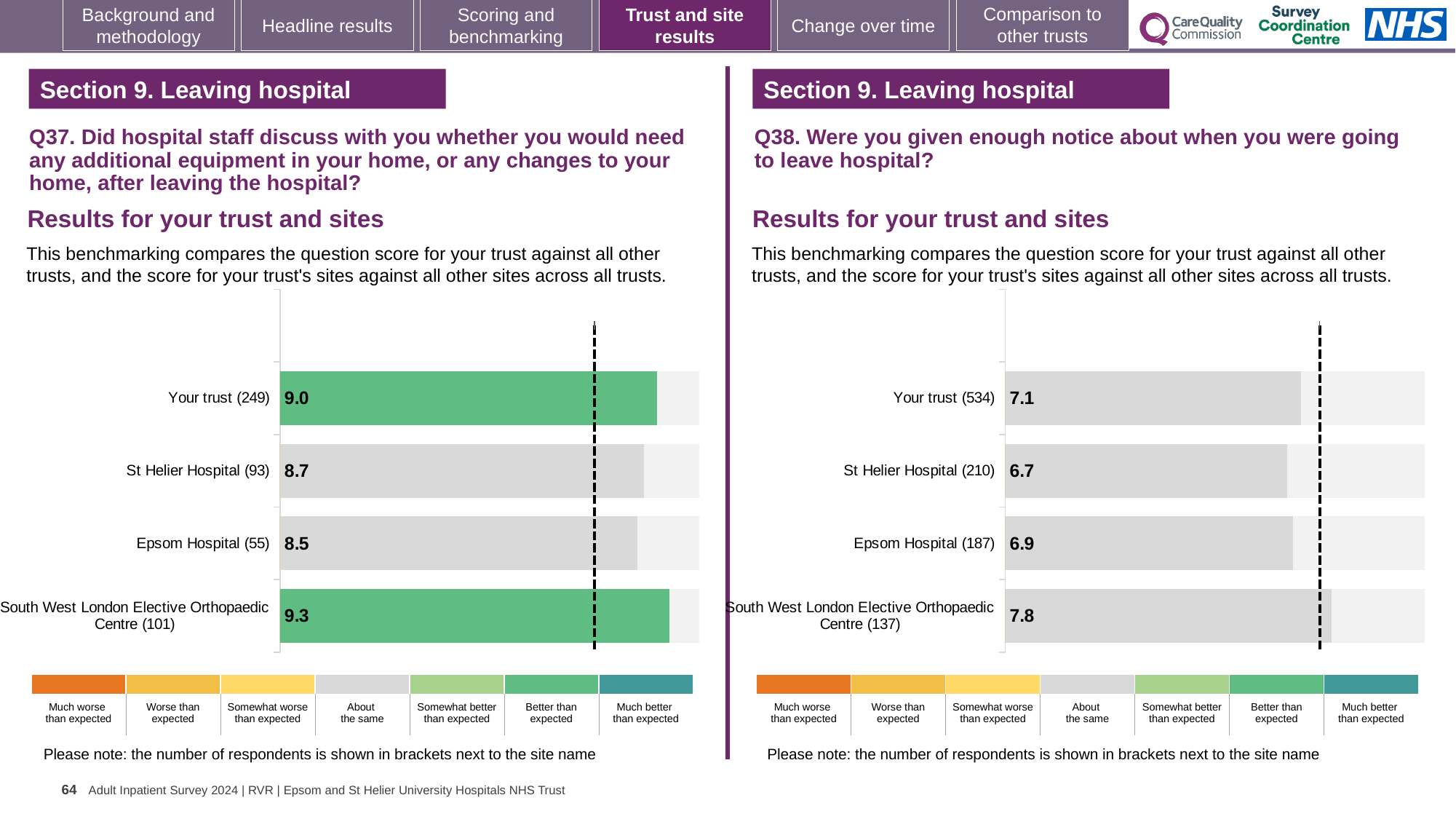
In the Q38 chart on the right, what is the score for St Helier Hospital? 6.7 In the Q37 chart on the left, what is the score for Your trust? 9.0 In the Q38 chart on the right, which site or trust has the lowest score? St Helier Hospital In the Q37 chart on the left, what is the score for Epsom Hospital? 8.5 In the Q37 chart on the left, what is the difference between the scores for South West London Elective Orthopaedic Centre and St Helier Hospital? 0.6 In the Q37 chart on the left, which site or trust has the lowest score? Epsom Hospital In the Q38 chart on the right, which is larger, the score for Your trust or the score for Epsom Hospital? Your trust How many bars are shown in the Q37 chart on the left? 4 What type of chart is used in the Q38 chart on the right? Bar chart In the Q37 chart on the left, which site or trust has the highest score? South West London Elective Orthopaedic Centre In the Q38 chart on the right, what is the difference between the scores for Your trust and St Helier Hospital? 0.4 In the Q38 chart on the right, what is the score for South West London Elective Orthopaedic Centre? 7.8